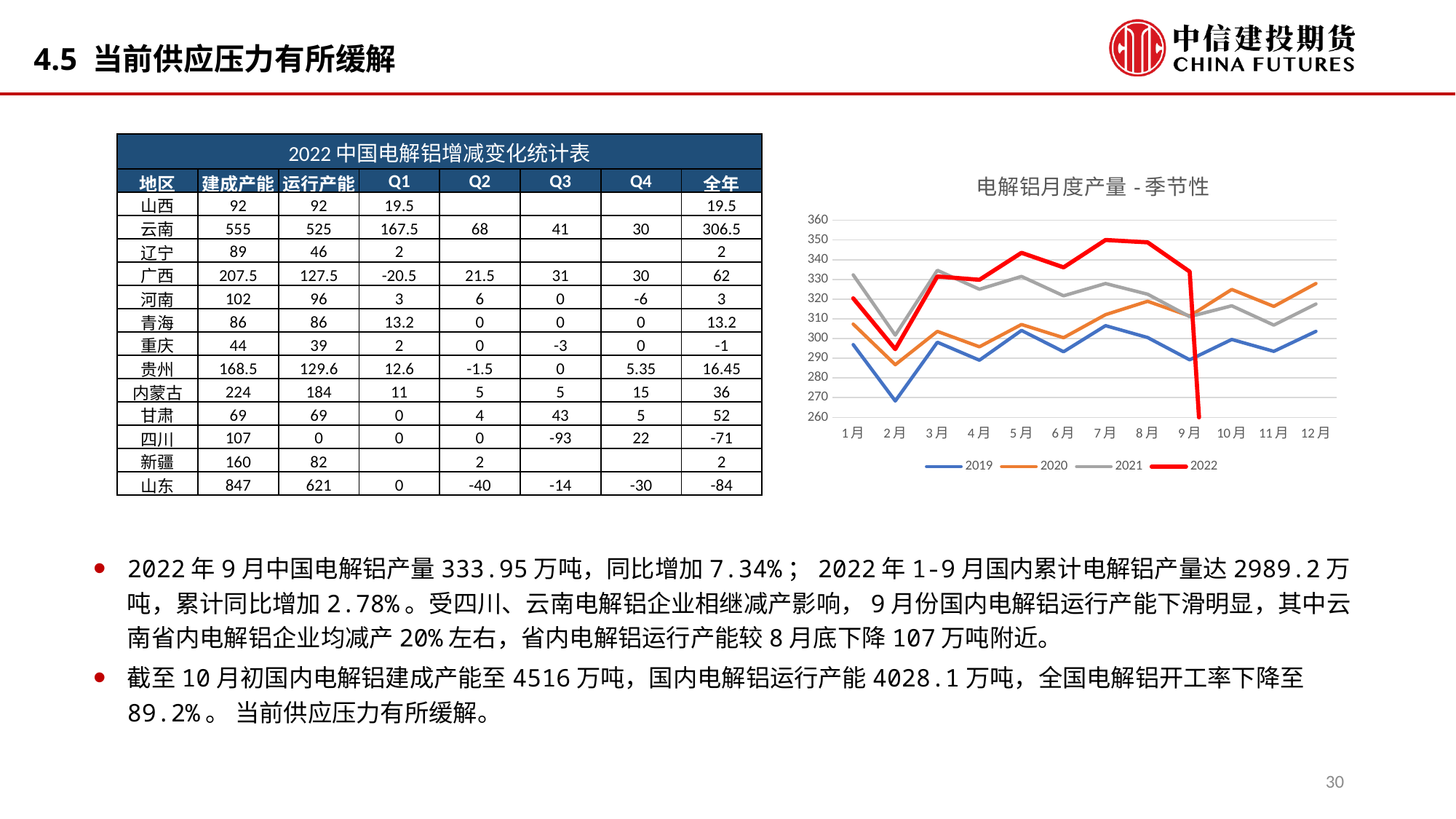
How many series does the legend of the 电解铝月度产量 - 季节性 chart list? 4 In the 电解铝月度产量 - 季节性 chart, do the series rise or fall from 1月 to 2月? fall In the 电解铝月度产量 - 季节性 chart, which series has the highest value in 7月? 2022 What kind of chart is the 电解铝月度产量 - 季节性 chart? line chart In the 电解铝月度产量 - 季节性 chart, is the 2020 value for 12月 greater or less than 320? greater In the 电解铝月度产量 - 季节性 chart, is the 2022 value for 7月 greater or less than 340? greater How many months are shown on the x axis of the 电解铝月度产量 - 季节性 chart? 12 What is the title of the line chart on the slide? 电解铝月度产量 - 季节性 In the 电解铝月度产量 - 季节性 chart, which month has the lowest value for the 2020 series? 2月 In the 电解铝月度产量 - 季节性 chart, which series is drawn in red? 2022 In the 电解铝月度产量 - 季节性 chart, which series has the lowest value in 2月? 2019 In the 电解铝月度产量 - 季节性 chart, is the 2019 value for 2月 greater or less than 280? less